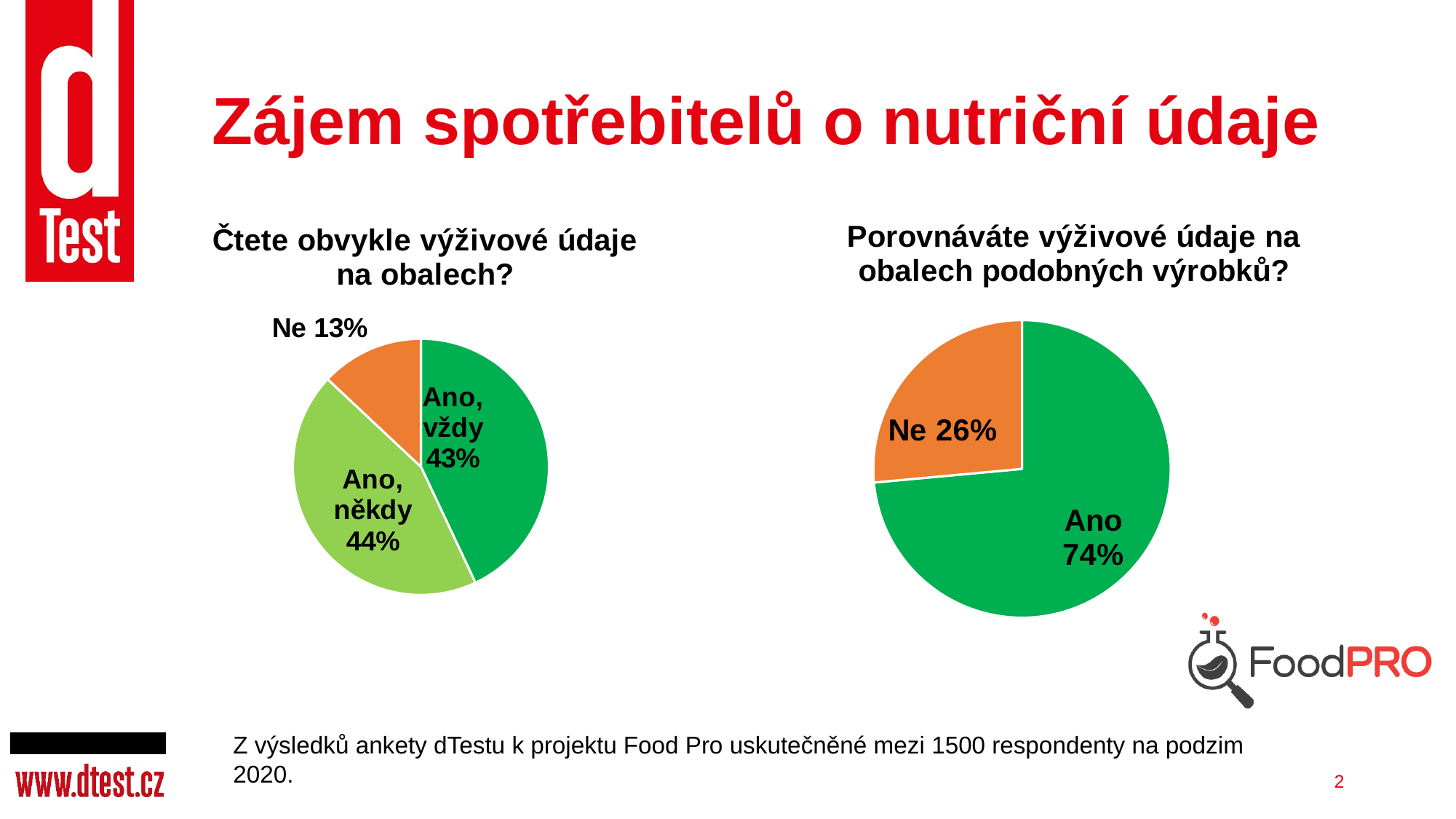
In the right chart "Porovnáváte výživové údaje na obalech podobných výrobků?", what share of respondents answered "Ne"? 26% In the left chart "Čtete obvykle výživové údaje na obalech?", what share of respondents answered "Ano, vždy"? 43% In the left chart "Čtete obvykle výživové údaje na obalech?", what share of respondents answered "Ano, někdy"? 44% In the left chart "Čtete obvykle výživové údaje na obalech?", which answer has the smallest share? Ne In the right chart "Porovnáváte výživové údaje na obalech podobných výrobků?", which answer has the larger share, "Ano" or "Ne"? Ano In the right chart "Porovnáváte výživové údaje na obalech podobných výrobků?", what share of respondents answered "Ano"? 74% In the left chart "Čtete obvykle výživové údaje na obalech?", how many slices does the pie have? 3 In the left chart "Čtete obvykle výživové údaje na obalech?", what is the difference in percentage points between "Ano, někdy" and "Ne"? 31 percentage points In the right chart "Porovnáváte výživové údaje na obalech podobných výrobků?", what colour is the "Ne" slice? Orange What kind of chart is used on the left, titled "Čtete obvykle výživové údaje na obalech?" Pie chart In the left chart "Čtete obvykle výživové údaje na obalech?", what share of respondents answered "Ne"? 13% In the right chart "Porovnáváte výživové údaje na obalech podobných výrobků?", what is the difference in percentage points between "Ano" and "Ne"? 48 percentage points